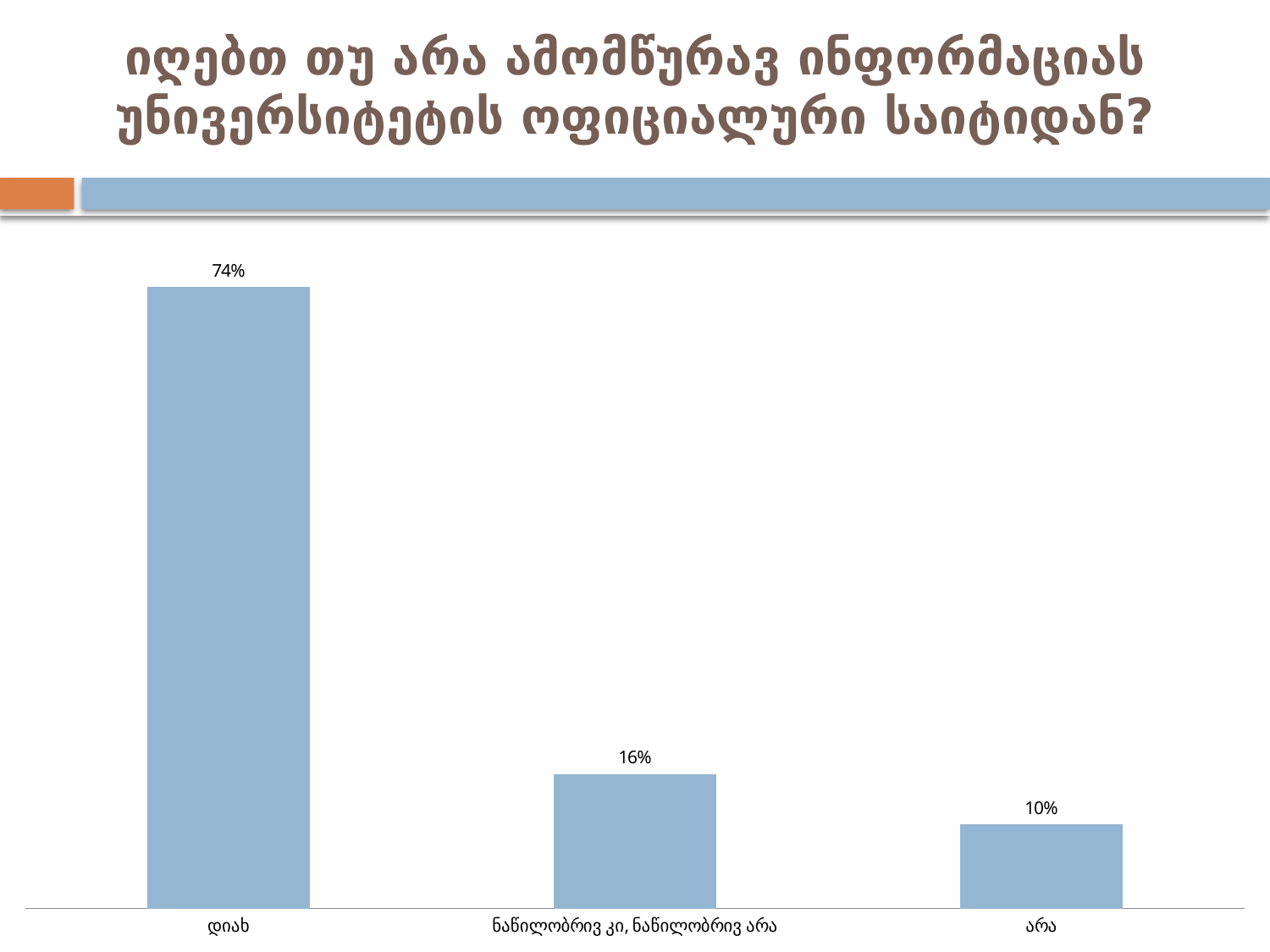
What kind of chart is shown on the slide? bar chart What is the difference between the values for "დიახ" and "არა"? 64% Which category has the highest value? დიახ Do the values rise or fall from left to right across the categories? fall How many categories are shown in the chart? 3 What is the value for the category "დიახ"? 74% Which is larger, the value for "ნაწილობრივ კი, ნაწილობრივ არა" or the value for "არა"? ნაწილობრივ კი, ნაწილობრივ არა What is the difference between the values for "ნაწილობრივ კი, ნაწილობრივ არა" and "არა"? 6% What is the value for the category "არა"? 10% What is the title of the slide? იღებთ თუ არა ამომწურავ ინფორმაციას უნივერსიტეტის ოფიციალური საიტიდან? What is the value for the category "ნაწილობრივ კი, ნაწილობრივ არა"? 16% Which category has the lowest value? არა